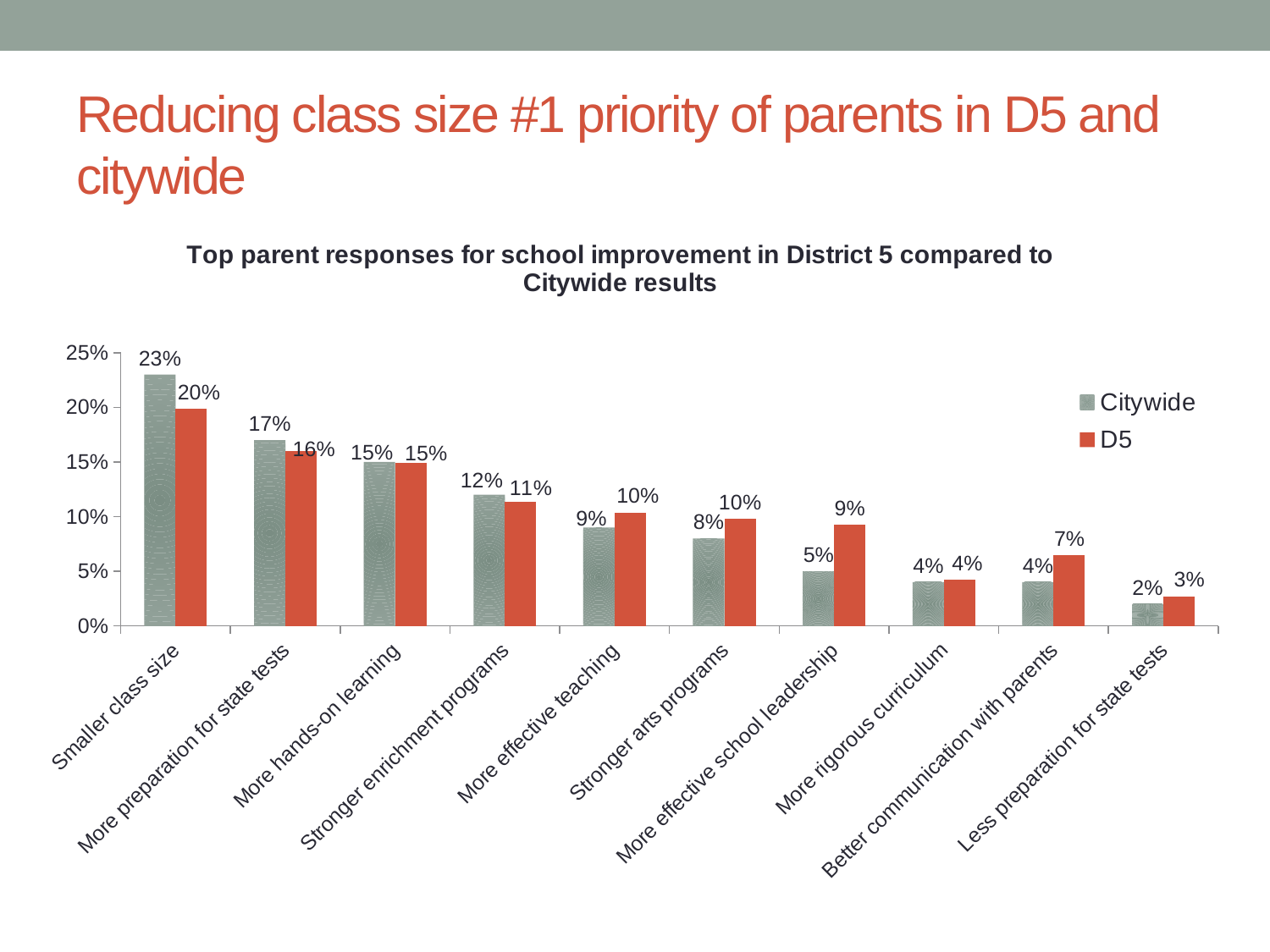
How many series does the legend list? 2 What is the difference between the D5 and Citywide values for More effective school leadership? 4% Which category has the lowest D5 value? Less preparation for state tests Which category has the highest Citywide value? Smaller class size How many categories are shown on the x axis? 10 Do the Citywide values rise or fall from left to right along the x axis? Fall What is the difference between the Citywide and D5 values for Smaller class size? 3% What is the Citywide value for Smaller class size? 23% What kind of chart is shown on the slide? Bar chart What is the D5 value for Better communication with parents? 7% What is the D5 value for More effective school leadership? 9% For Stronger arts programs, which is larger: the Citywide value or the D5 value? D5